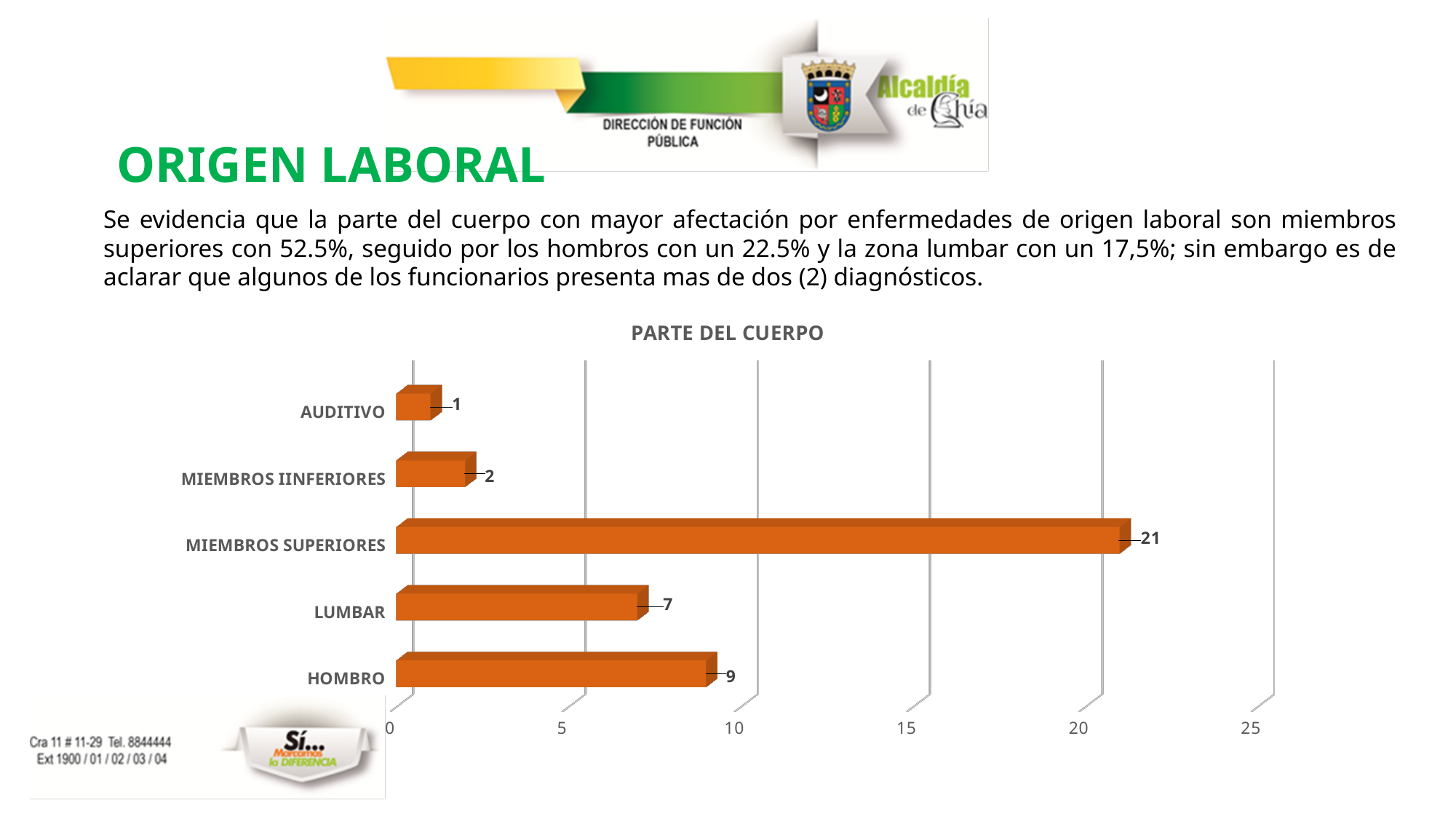
Which category has the highest value in the PARTE DEL CUERPO chart? MIEMBROS SUPERIORES What is the difference between the values for HOMBRO and LUMBAR? 2 Which is larger, the value for LUMBAR or the value for MIEMBROS IINFERIORES? LUMBAR What is the value for HOMBRO in the PARTE DEL CUERPO chart? 9 What is the value for AUDITIVO in the PARTE DEL CUERPO chart? 1 What kind of chart is the PARTE DEL CUERPO chart? Bar chart Is the value for MIEMBROS SUPERIORES greater or less than 20? greater What is the difference between the values for MIEMBROS SUPERIORES and HOMBRO? 12 What is the value for LUMBAR in the PARTE DEL CUERPO chart? 7 How many categories are shown in the PARTE DEL CUERPO chart? 5 What is the value for MIEMBROS SUPERIORES in the PARTE DEL CUERPO chart? 21 Which category has the lowest value in the PARTE DEL CUERPO chart? AUDITIVO